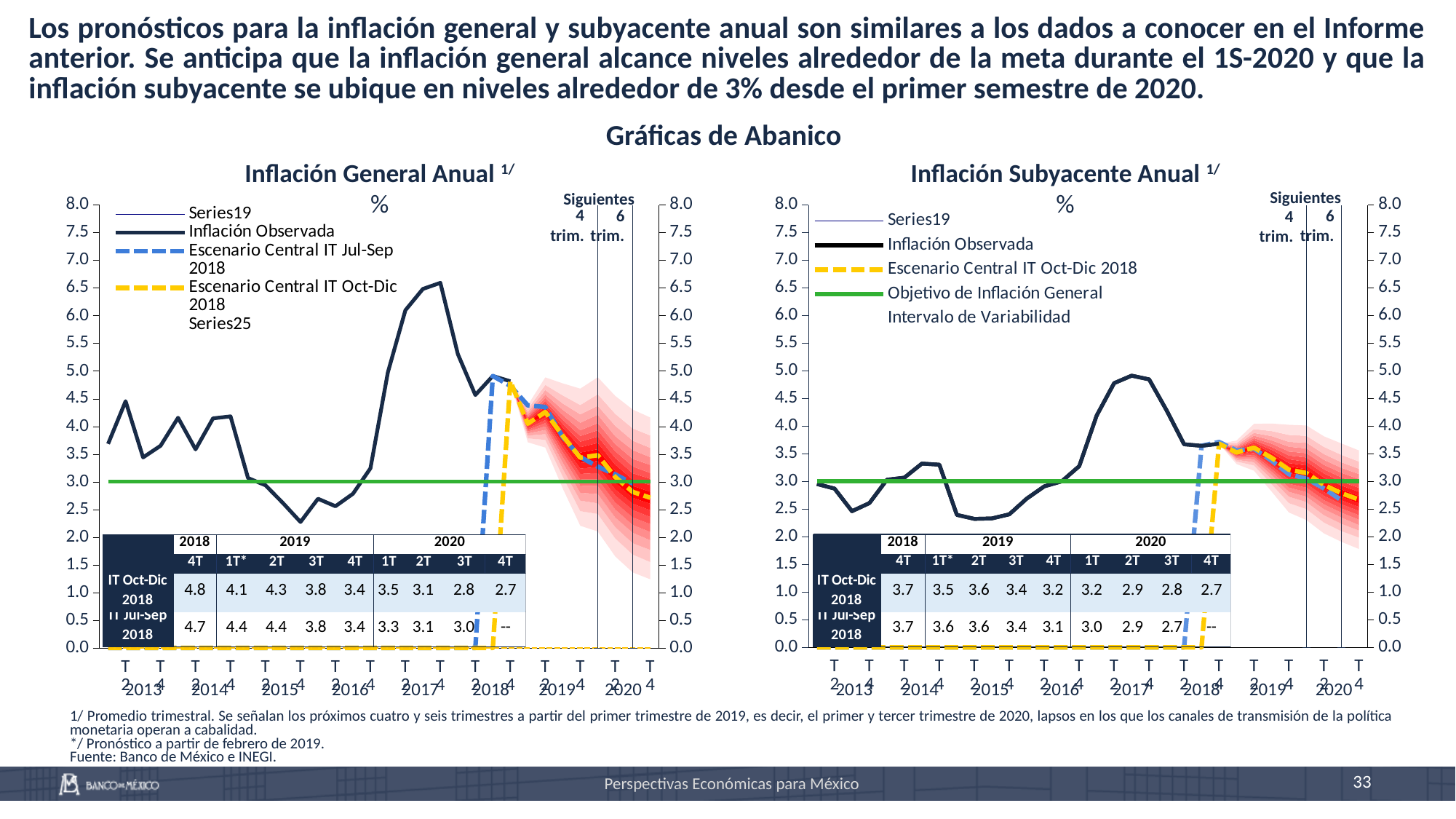
In the Inflación General Anual chart table, what is the difference between the IT Oct-Dic 2018 forecasts for 4T 2018 and 4T 2020? 2.1 How many entries does the legend of the Inflación Subyacente Anual chart list? 5 In the Inflación General Anual chart table, which is larger for 1T 2019: the IT Oct-Dic 2018 forecast or the IT Jul-Sep 2018 forecast? IT Jul-Sep 2018 In the Inflación General Anual chart, what is the IT Jul-Sep 2018 forecast for 1T 2020 shown in the table? 3.3 In the Inflación Subyacente Anual chart, what is the IT Jul-Sep 2018 forecast for 4T 2019 shown in the table? 3.1 What kind of chart is the Inflación General Anual chart? Line chart (fan chart) In the Inflación Subyacente Anual chart, is the peak of the observed inflation line in 2017 greater or less than 4.5? greater In the Inflación Subyacente Anual chart table, which quarter has the lowest IT Oct-Dic 2018 forecast? 4T 2020 In the Inflación Subyacente Anual chart, what is the IT Oct-Dic 2018 forecast for 4T 2020 shown in the table? 2.7 In the Inflación General Anual chart, what is the IT Oct-Dic 2018 forecast for 4T 2018 shown in the table? 4.8 In the Inflación General Anual chart, is the peak of the observed inflation line in 2017 greater or less than 6.0? greater In the Inflación General Anual chart table, which quarter has the highest IT Oct-Dic 2018 forecast? 4T 2018